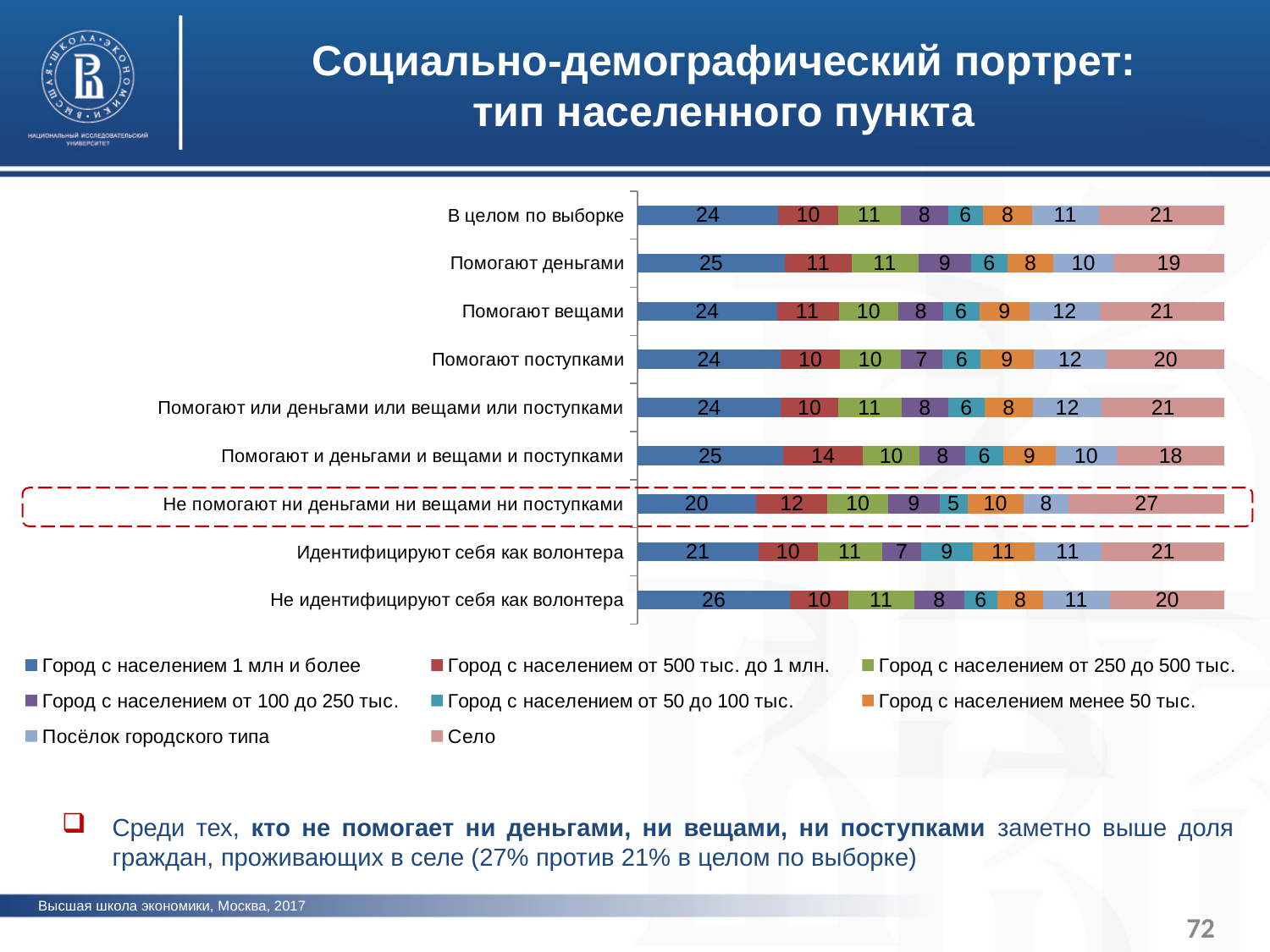
What is the difference between the "Село" value for "Не помогают ни деньгами ни вещами ни поступками" and for "В целом по выборке"? 6 Which category is highlighted with a red dashed outline? Не помогают ни деньгами ни вещами ни поступками What is the value of "Город с населением 1 млн и более" for "В целом по выборке"? 24 Which is larger: the "Город с населением 1 млн и более" value for "Не идентифицируют себя как волонтера" or for "Идентифицируют себя как волонтера"? Не идентифицируют себя как волонтера Which category has the highest value for "Село"? Не помогают ни деньгами ни вещами ни поступками What is the total of the stacked bar for "Помогают или деньгами или вещами или поступками"? 100 What type of chart is shown on the slide? Stacked bar chart How many series does the legend list? 8 How many categories (rows) are plotted in the chart? 9 Which category has the lowest value for "Город с населением 1 млн и более"? Не помогают ни деньгами ни вещами ни поступками What is the value of "Село" for "Не помогают ни деньгами ни вещами ни поступками"? 27 What is the value of "Город с населением от 500 тыс. до 1 млн." for "Помогают и деньгами и вещами и поступками"? 14